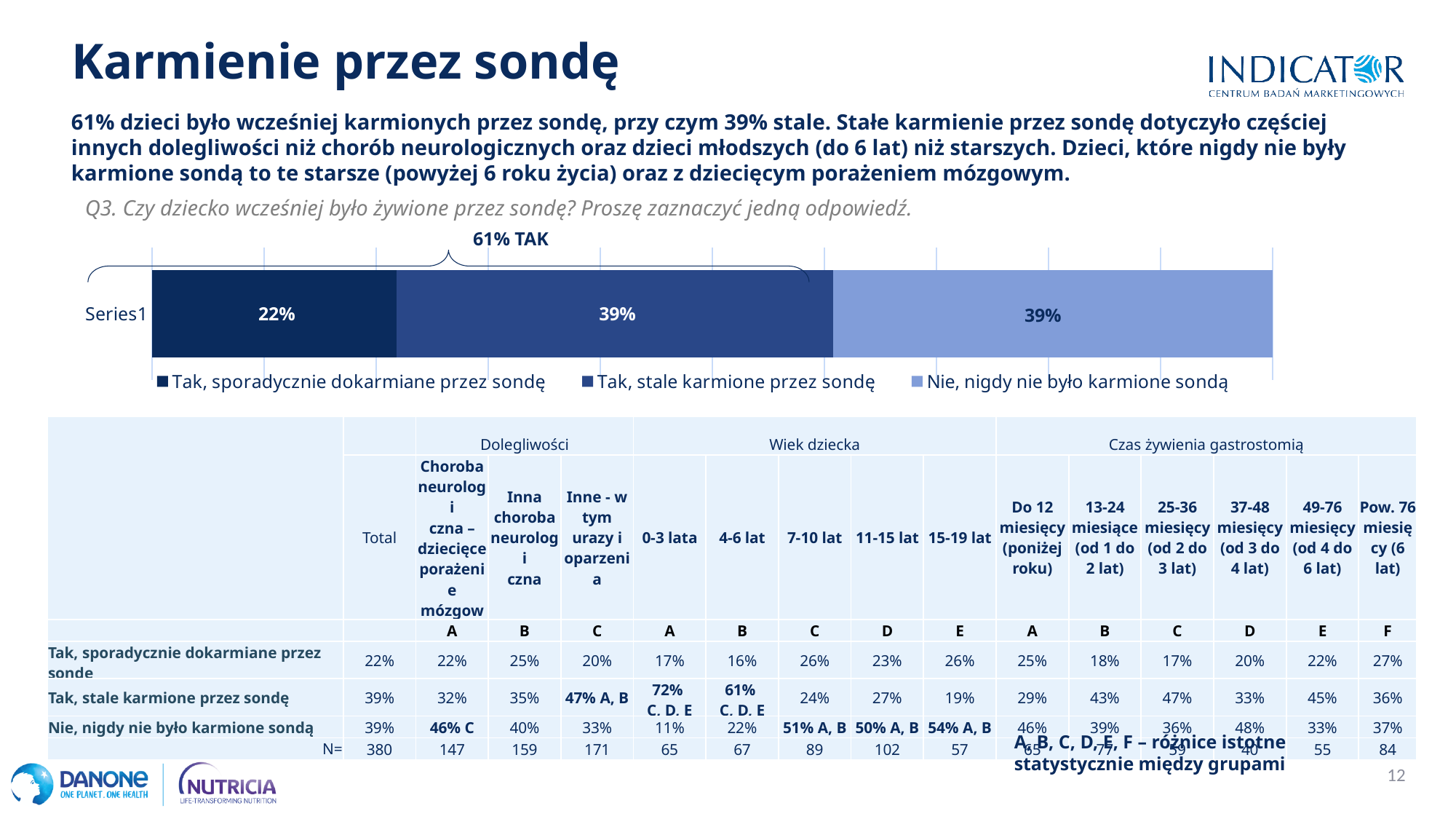
What kind of chart is shown on the slide? Stacked bar chart How many series does the legend of the bar chart list? 3 What is the total of the three segments in the stacked bar? 100% What value does the bar chart show for "Nie, nigdy nie było karmione sondą"? 39% Which segment of the stacked bar has the smallest value? Tak, sporadycznie dokarmiane przez sondę What percentage of children were occasionally fed by tube ("Tak, sporadycznie dokarmiane przez sondę") according to the bar chart? 22% What is the difference between the "Tak, stale karmione przez sondę" segment and the "Tak, sporadycznie dokarmiane przez sondę" segment? 17 percentage points How many bars does the chart contain? 1 What label is written above the bracket spanning the first two segments of the bar? 61% TAK What is the category label shown to the left of the bar? Series1 Which is larger in the bar chart: "Tak, sporadycznie dokarmiane przez sondę" or "Tak, stale karmione przez sondę"? Tak, stale karmione przez sondę What value does the bar chart show for "Tak, stale karmione przez sondę"? 39%